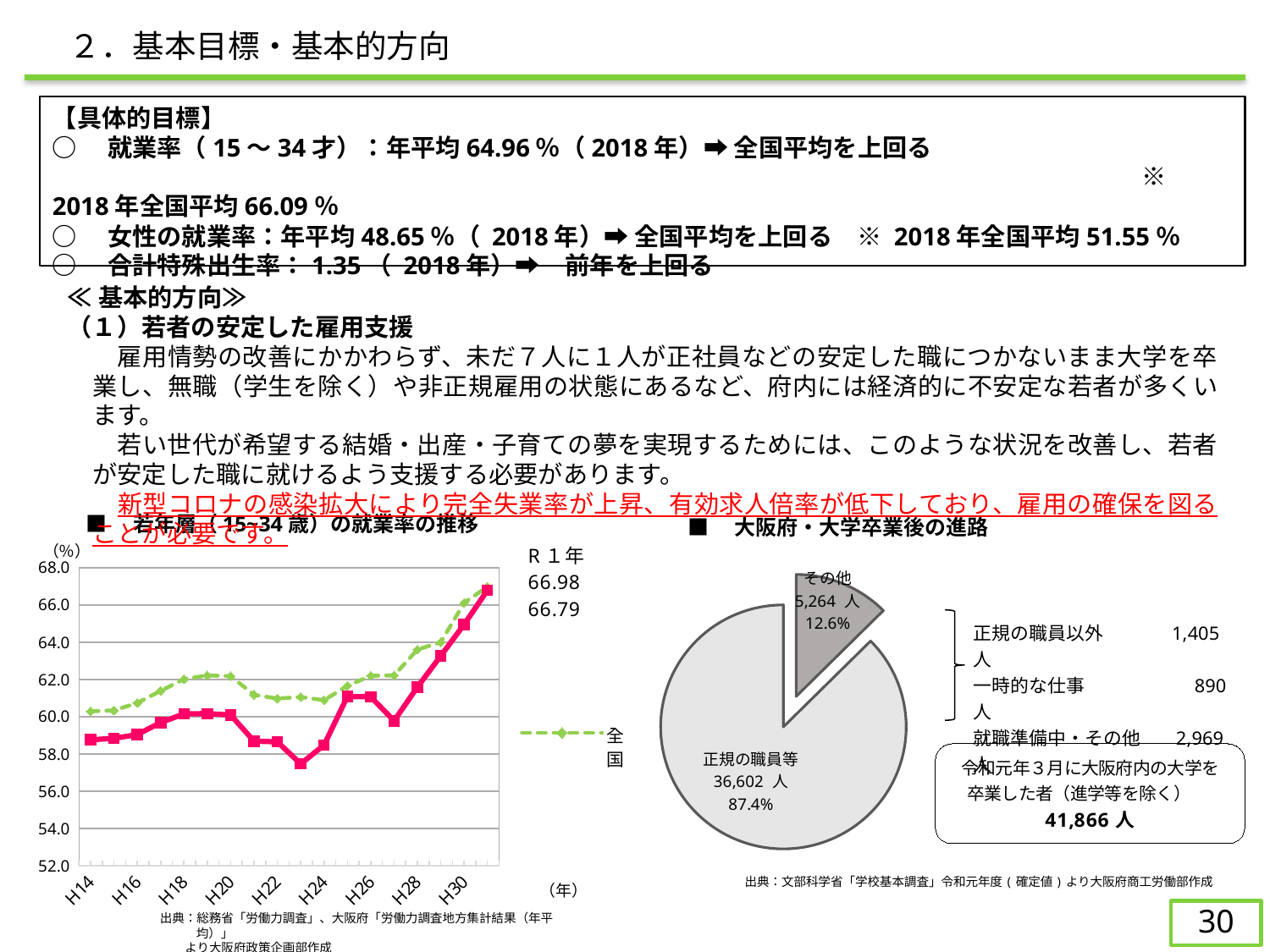
In the pie chart 大阪府・大学卒業後の進路, how many people are listed under 一時的な仕事 in the breakdown of その他? 890 人 In the chart 若年層（15-34歳）の就業率の推移, how many series are plotted? 2 In the pie chart 大阪府・大学卒業後の進路, what share of graduates are 正規の職員等? 87.4% In the pie chart 大阪府・大学卒業後の進路, how many people are in the その他 slice? 5,264 人 What kind of chart is 若年層（15-34歳）の就業率の推移? line chart What kind of chart is 大阪府・大学卒業後の進路? pie chart In the pie chart 大阪府・大学卒業後の進路, which slice is larger, 正規の職員等 or その他? 正規の職員等 In the chart 若年層（15-34歳）の就業率の推移, is the value of the solid pink line at H23 greater or less than 58.0? less In the pie chart 大阪府・大学卒業後の進路, what is the total number of graduates shown (進学等を除く)? 41,866 人 In the pie chart 大阪府・大学卒業後の進路, how many more people are 正規の職員等 than その他? 31,338 人 In the pie chart 大阪府・大学卒業後の進路, how many slices does the pie have? 2 In the chart 若年層（15-34歳）の就業率の推移, do the values generally rise or fall from H14 to the last year? rise